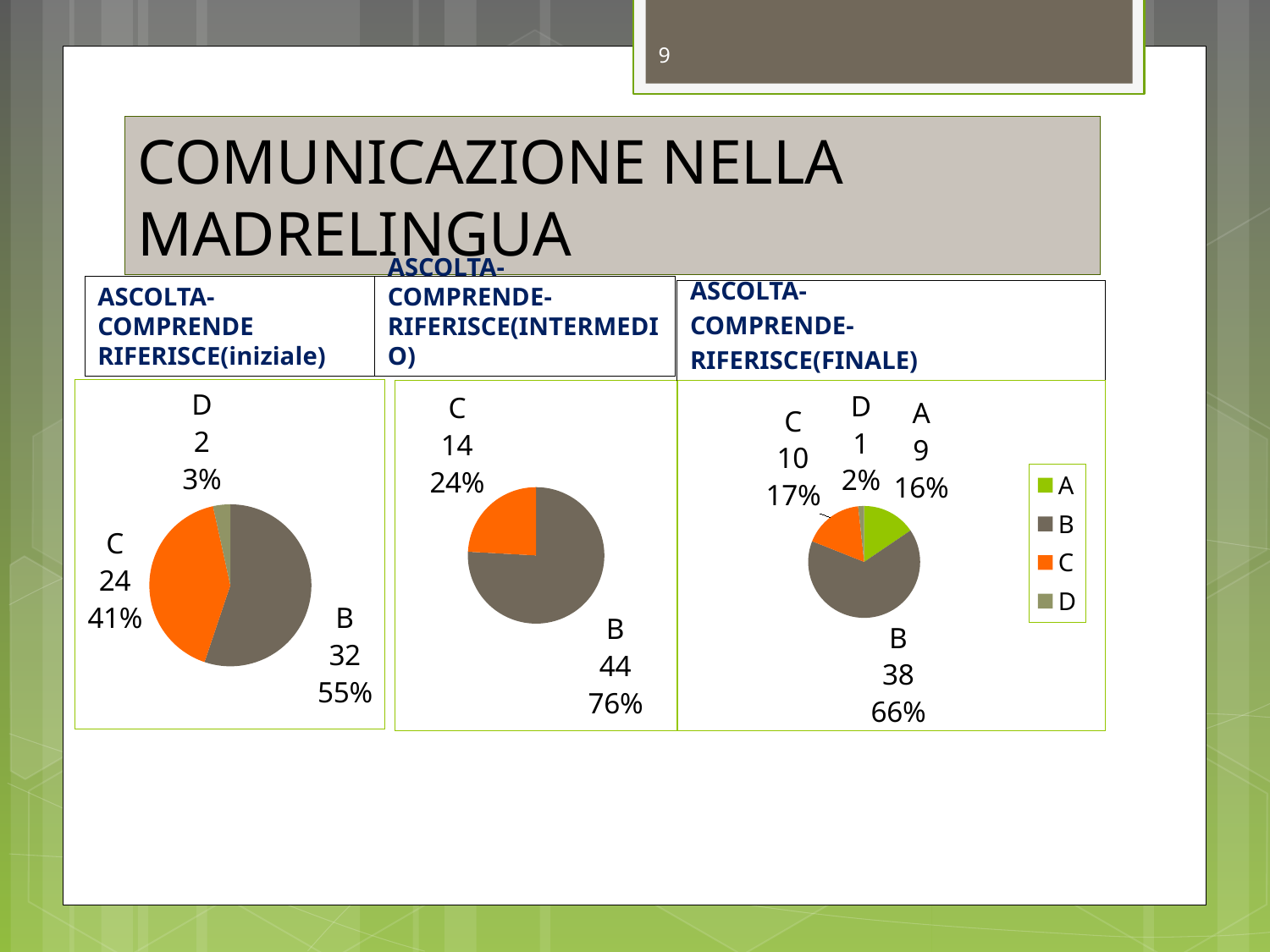
In the ASCOLTA-COMPRENDE-RIFERISCE(iniziale) pie chart, what value is shown for category B? 32 In the ASCOLTA-COMPRENDE-RIFERISCE(FINALE) pie chart, which is larger, the value for C or the value for A? C In the ASCOLTA-COMPRENDE-RIFERISCE(FINALE) pie chart, which category has the largest slice? B In the ASCOLTA-COMPRENDE-RIFERISCE(INTERMEDIO) pie chart, what percentage share does category B have? 76% In the ASCOLTA-COMPRENDE-RIFERISCE(iniziale) pie chart, what percentage share does category C have? 41% In the ASCOLTA-COMPRENDE-RIFERISCE(iniziale) pie chart, which category has the smallest slice? D In the ASCOLTA-COMPRENDE-RIFERISCE(iniziale) pie chart, what is the difference between the values for B and C? 8 In the ASCOLTA-COMPRENDE-RIFERISCE(FINALE) pie chart, what value is shown for category A? 9 How many entries does the legend next to the ASCOLTA-COMPRENDE-RIFERISCE(FINALE) chart list? 4 What type of chart is used for ASCOLTA-COMPRENDE-RIFERISCE(iniziale)? Pie chart In the ASCOLTA-COMPRENDE-RIFERISCE(INTERMEDIO) pie chart, what value is shown for category C? 14 How many slices does the ASCOLTA-COMPRENDE-RIFERISCE(INTERMEDIO) pie chart have? 2